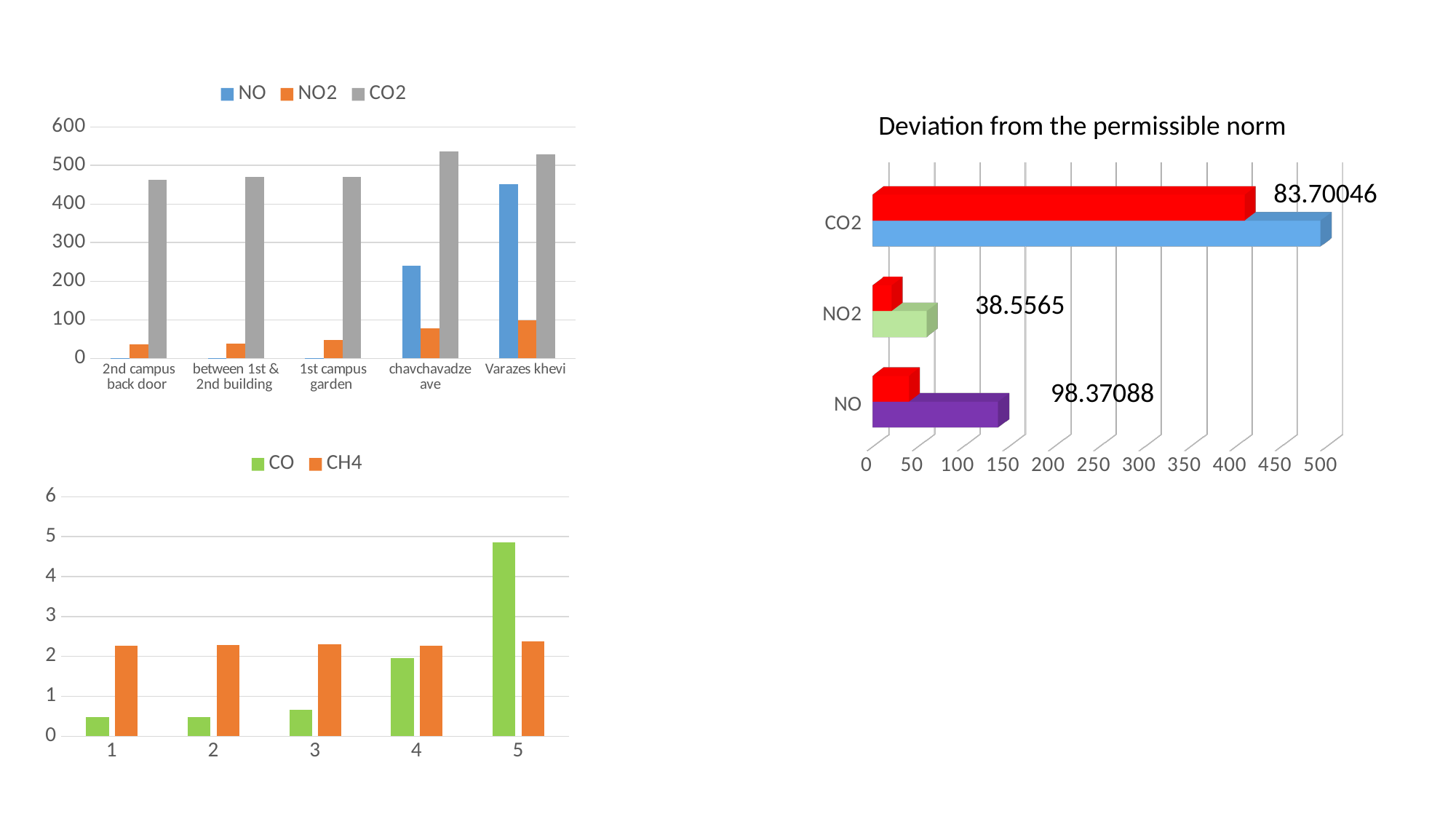
In the top-left chart, is the CO2 value for chavchavadze ave greater or less than 500? greater In the chart titled 'Deviation from the permissible norm', what data label is printed for NO? 98.37088 What is the title of the chart on the right? Deviation from the permissible norm In the bottom-left chart, is the CO value for category 5 greater or less than 4? greater In the top-left chart, is the NO value for Varazes khevi greater or less than 400? greater In the chart titled 'Deviation from the permissible norm', what data label is printed for NO2? 38.5565 In the bottom-left chart, at category 5, which is larger, CO or CH4? CO In the top-left chart, which location has the highest NO value? Varazes khevi In the top-left chart, how many locations are shown on the x axis? 5 In the top-left chart, how many series does the legend list? 3 In the bottom-left chart, which category has the highest CO value? 5 In the bottom-left chart, which series is shown in green? CO